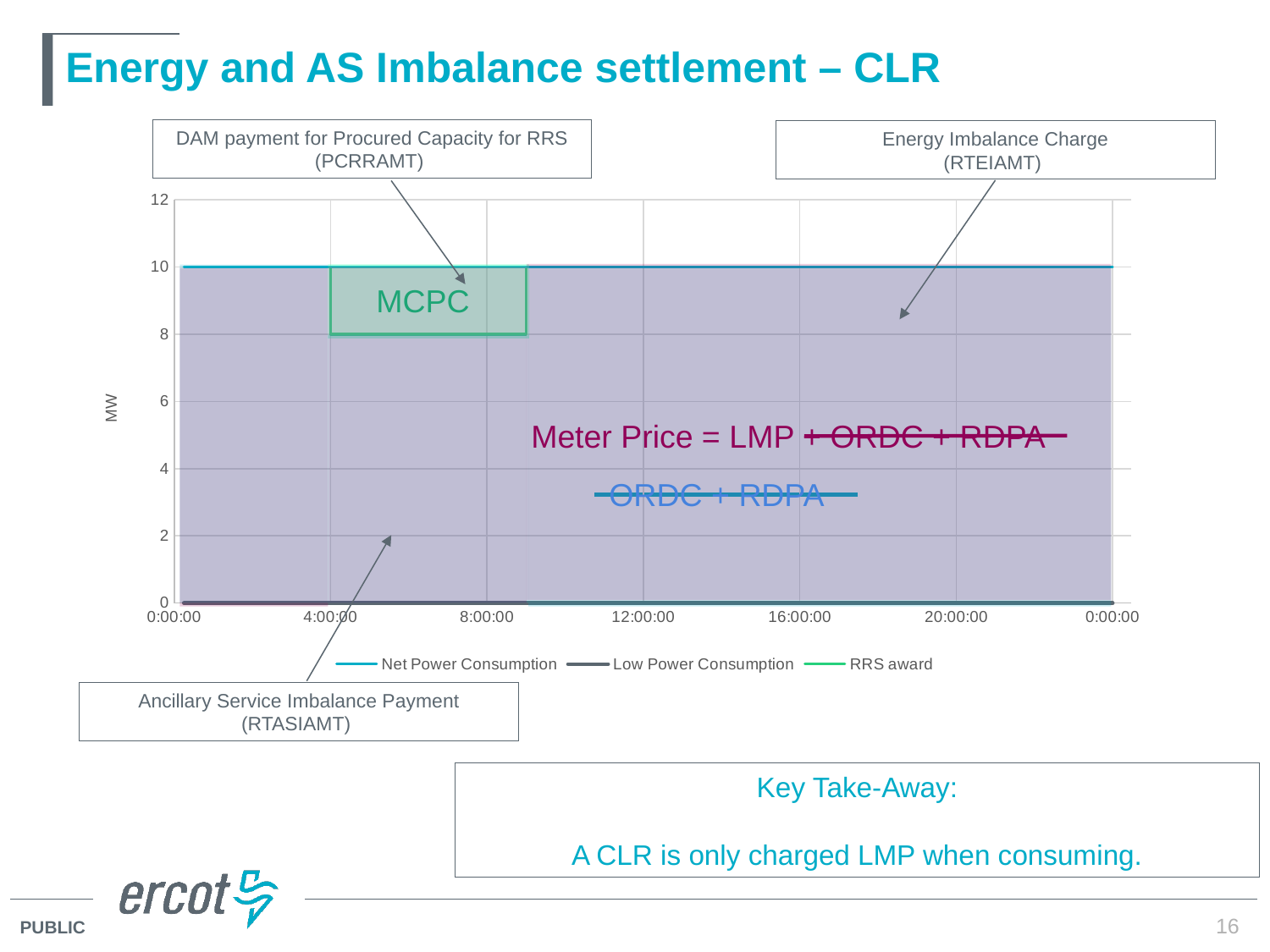
How many series does the chart legend list? 3 Is the value for Low Power Consumption greater or less than 2? less What is the difference in MW between Net Power Consumption and Low Power Consumption? 10 What kind of chart is shown on the slide? line chart Which is larger, Net Power Consumption or Low Power Consumption? Net Power Consumption What label is printed inside the green RRS award box? MCPC What is the value of Low Power Consumption in MW? 0 Does the Net Power Consumption line rise, fall, or stay flat across the x axis? stays flat At what MW value is the lower edge of the RRS award box? 8 What is the highest tick value shown on the y axis? 12 What is the value of Net Power Consumption in MW across the day? 10 Is the value for Net Power Consumption greater or less than 6? greater